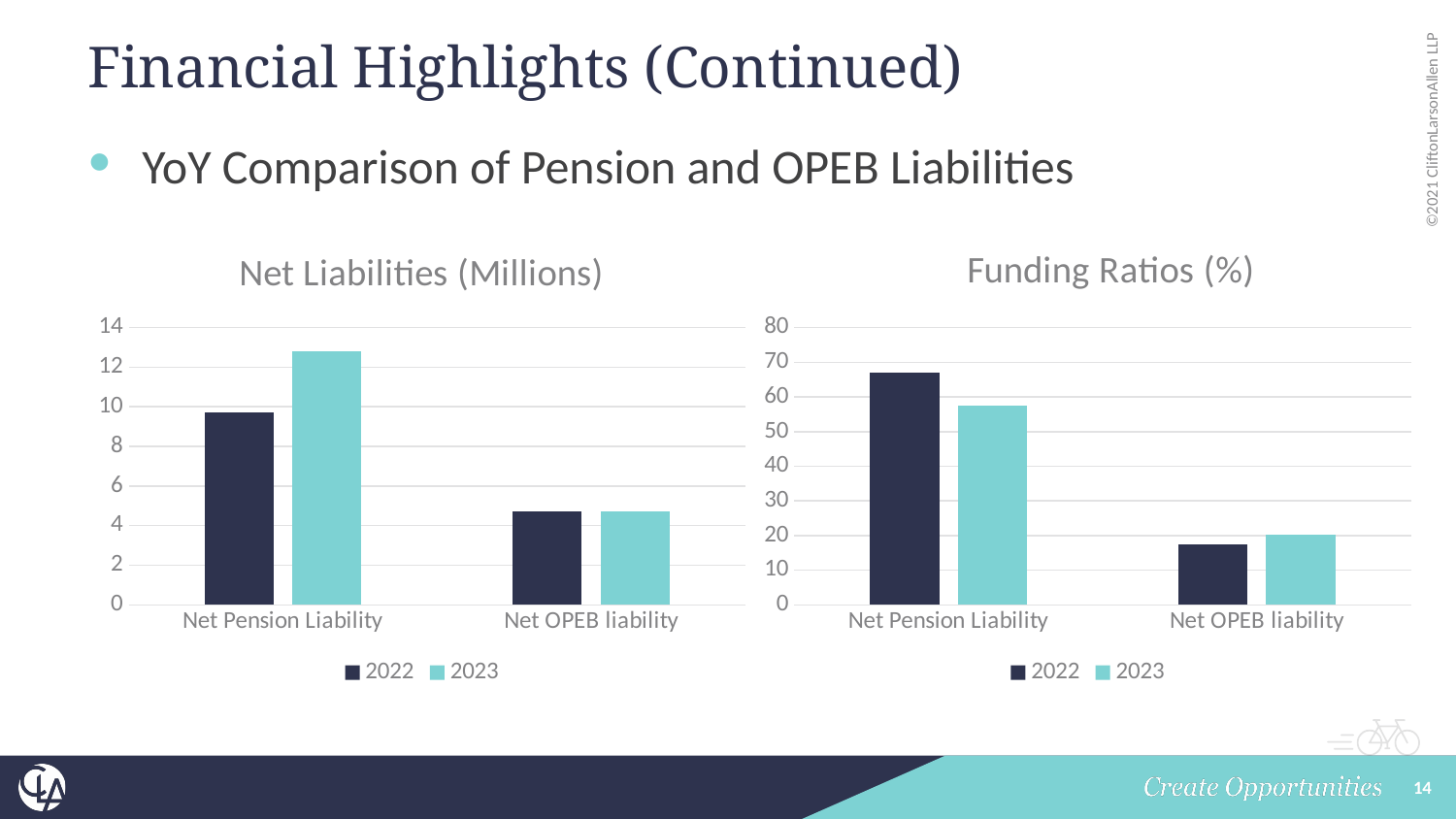
How many series does the legend of the "Funding Ratios (%)" chart list? 2 In the "Net Liabilities (Millions)" chart, which is larger for Net Pension Liability, the 2022 value or the 2023 value? 2023 How many categories are shown on the x axis of the "Net Liabilities (Millions)" chart? 2 In the "Net Liabilities (Millions)" chart, which bar is the highest? Net Pension Liability, 2023 What is the title of the chart on the right side of the slide? Funding Ratios (%) In the "Funding Ratios (%)" chart, is the 2022 value for Net Pension Liability greater or less than 60? greater In the "Funding Ratios (%)" chart, which is larger for Net Pension Liability, the 2022 value or the 2023 value? 2022 What kind of chart is the "Net Liabilities (Millions)" chart? bar chart In the "Funding Ratios (%)" chart, which bar is the lowest? Net OPEB liability, 2022 In the "Funding Ratios (%)" chart, is the 2023 value for Net OPEB liability greater or less than 30? less In the "Net Liabilities (Millions)" chart, is the 2023 value for Net Pension Liability greater or less than 12? greater